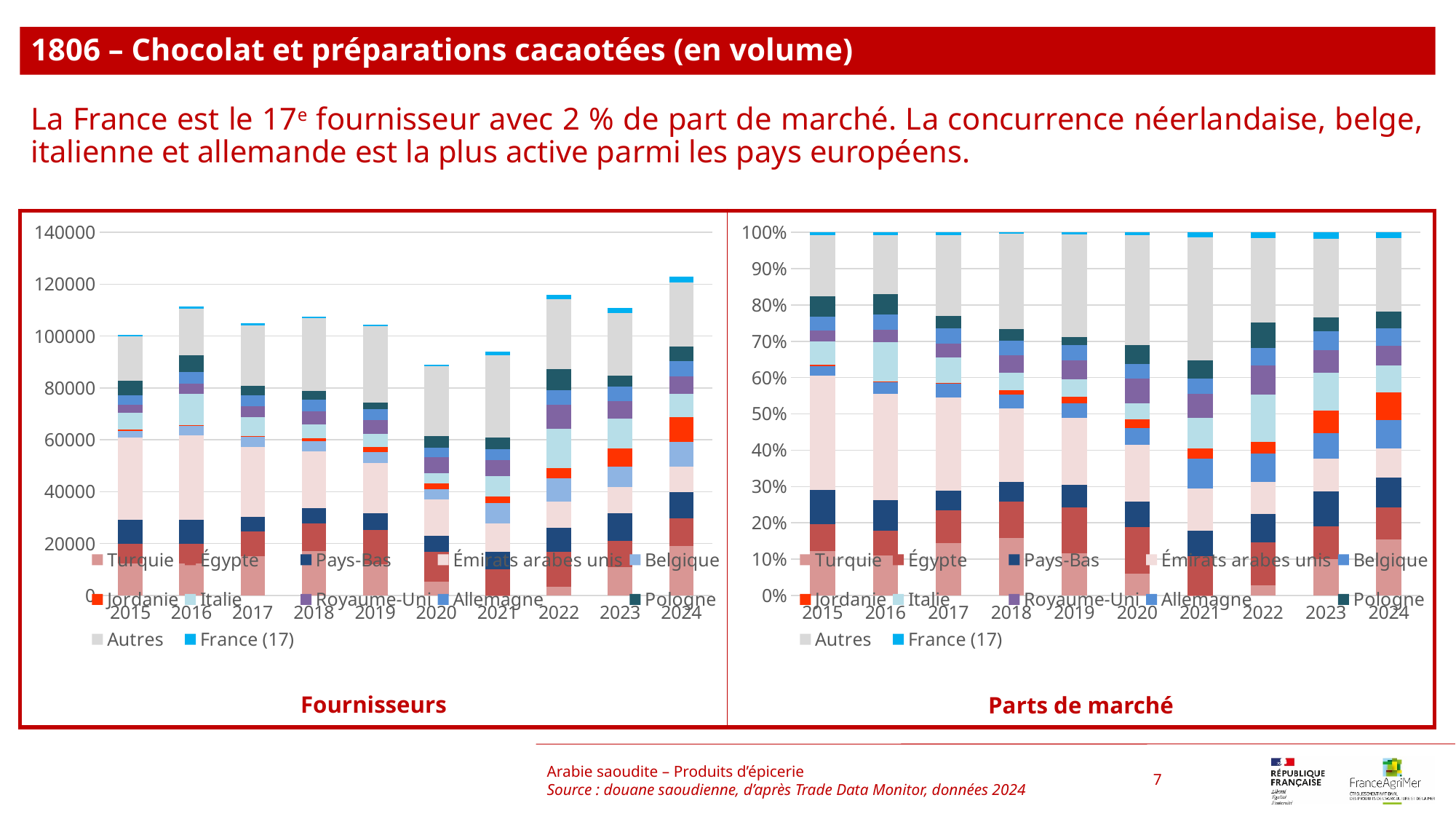
What is the title of the chart on the right of the slide? Parts de marché In the legend of the 'Parts de marché' chart, which series is labelled with a rank in parentheses? France (17) In the 'Fournisseurs' chart, is the total bar for 2021 greater or less than 100000? less In the 'Fournisseurs' chart, which year has the larger total bar, 2016 or 2017? 2016 How many years are shown on the x axis of the 'Fournisseurs' chart? 10 How many series does the legend of the 'Parts de marché' chart list? 12 In the 'Fournisseurs' chart, is the total bar for 2022 greater or less than 100000? greater In the 'Fournisseurs' chart, is the total bar for 2020 greater or less than 100000? less In the 'Fournisseurs' chart, which year has the highest total bar? 2024 In the 'Fournisseurs' chart, which year has the lowest total bar? 2020 What kind of chart is the 'Fournisseurs' chart on the left? Stacked bar chart In the 'Fournisseurs' chart, does the total bar rise or fall from 2019 to 2020? fall